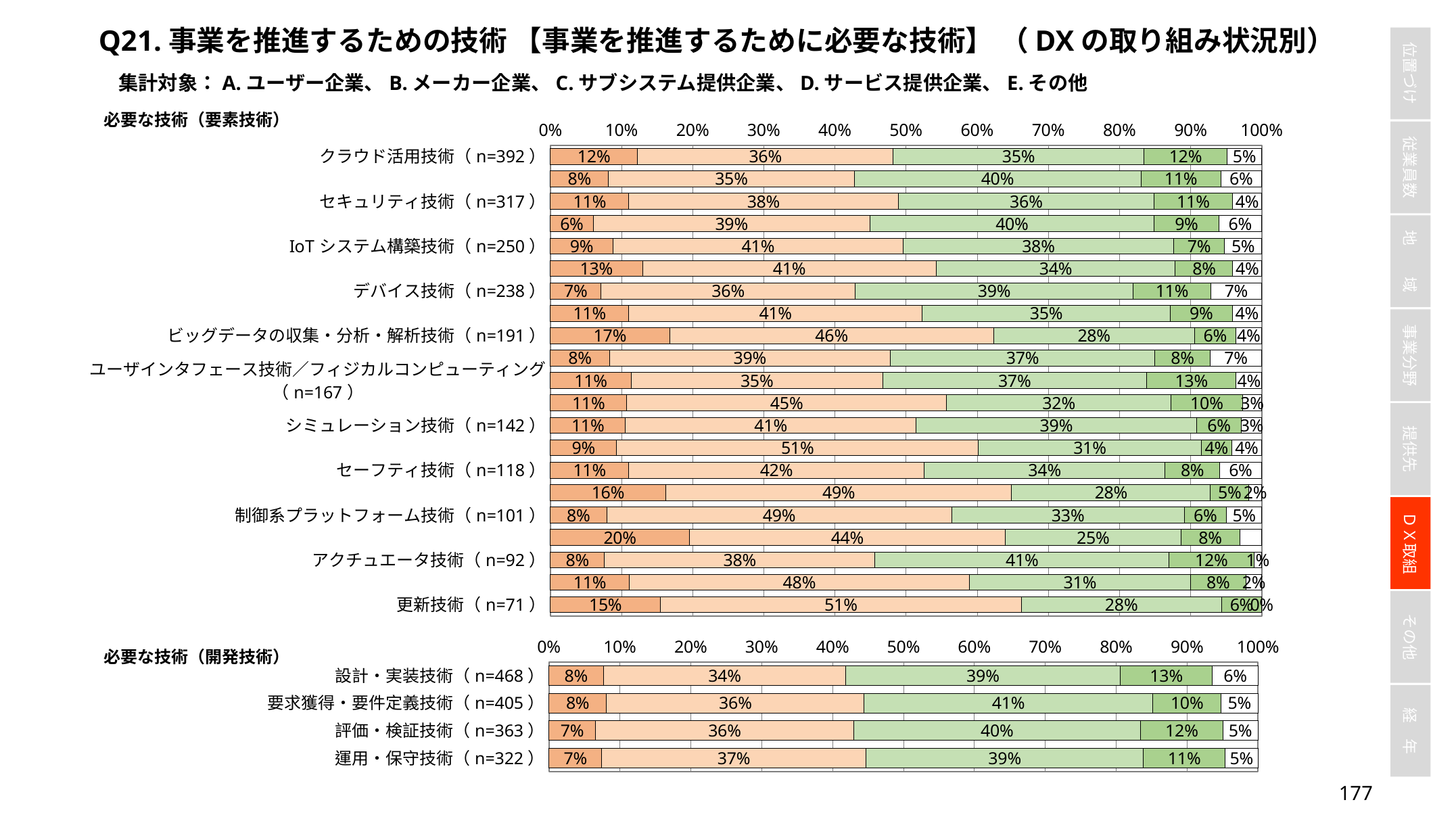
In the bottom chart (必要な技術（開発技術）), what is the difference between the fourth (dark green) segment of 設計・実装技術 and that of 要求獲得・要件定義技術? 3 percentage points In the bottom chart (必要な技術（開発技術）), what is the value of the fourth (dark green) segment for 評価・検証技術? 12% In the bottom chart (必要な技術（開発技術）), what is the total of all segments in the 設計・実装技術 bar? 100% What kind of chart is the bottom chart (必要な技術（開発技術）)? Stacked bar chart How many categories are shown in the bottom chart (必要な技術（開発技術）)? 4 In the bottom chart (必要な技術（開発技術）), which category has the largest third (light green) segment? 要求獲得・要件定義技術 In the bottom chart (必要な技術（開発技術）), what is the value of the second (light orange) segment for 運用・保守技術? 37% In the bottom chart (必要な技術（開発技術）), what is the value of the first (leftmost, dark orange) segment for 設計・実装技術? 8% In the top chart (必要な技術（要素技術）), what is the value of the first (dark orange) segment of the bar labelled ビッグデータの収集・分析・解析技術 (n=191)? 17% In the bottom chart (必要な技術（開発技術）), what is the value of the third (light green) segment for 要求獲得・要件定義技術? 41% In the top chart (必要な技術（要素技術）), what is the value of the second (light orange) segment of the bar labelled 更新技術 (n=71)? 51% In the bottom chart (必要な技術（開発技術）), which has the larger first (dark orange) segment: 設計・実装技術 or 運用・保守技術? 設計・実装技術